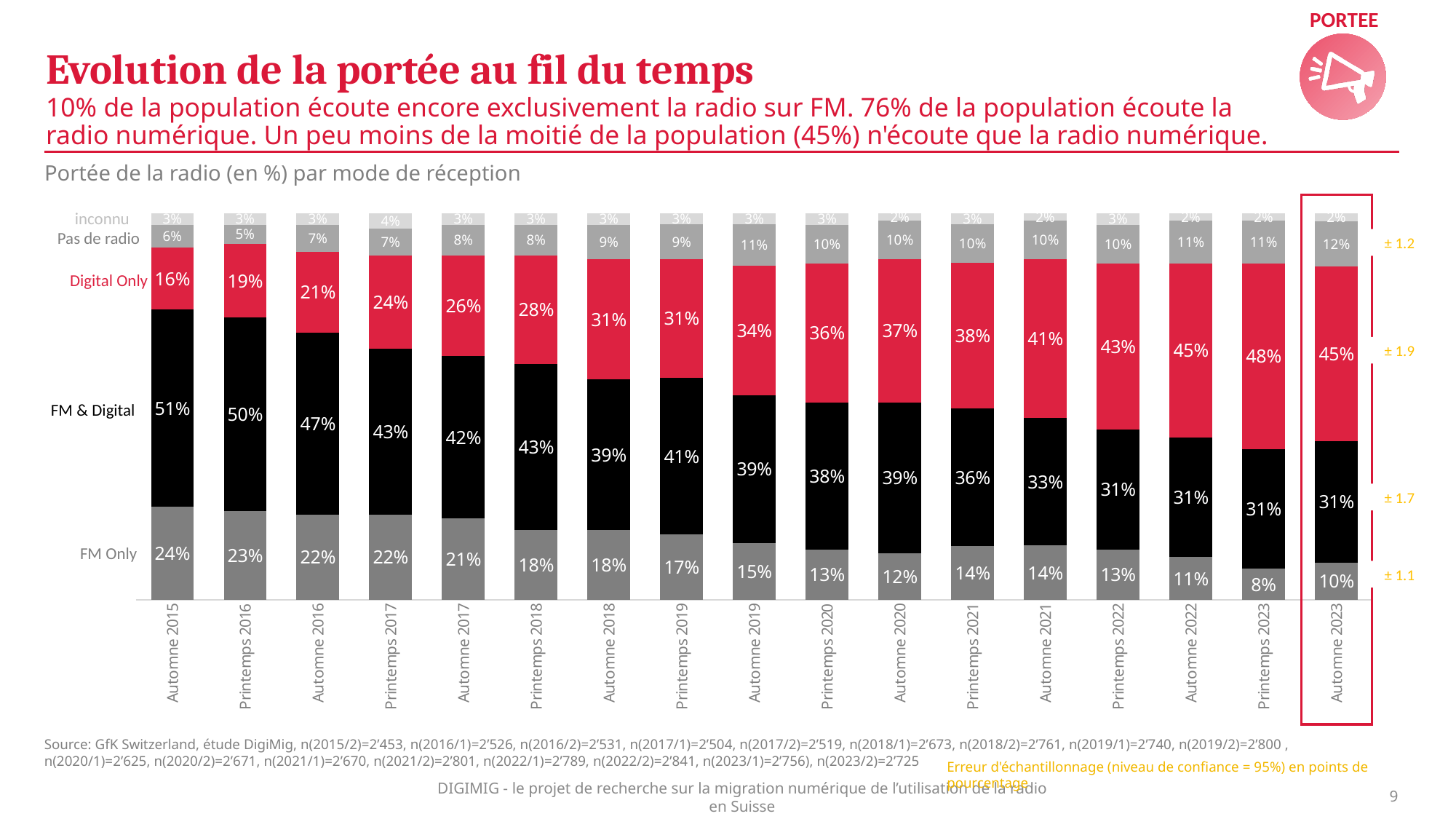
In which period is the FM Only value lowest? Printemps 2023 What is the FM & Digital value for Automne 2015? 51% What kind of chart is shown on the slide? stacked bar chart What is the combined value of FM Only and FM & Digital for Automne 2023? 41% Which is larger for Automne 2021: the Digital Only value or the FM & Digital value? Digital Only How many time periods are shown along the x axis of the chart? 17 How does the FM Only value change from Automne 2015 to Automne 2023? It falls What is the Pas de radio value for Automne 2023? 12% In which period is the Digital Only value highest? Printemps 2023 What is the Digital Only value for Printemps 2023? 48% What is the difference between the Digital Only value for Automne 2023 and the Digital Only value for Automne 2015? 29% What is the FM Only value for Automne 2023? 10%